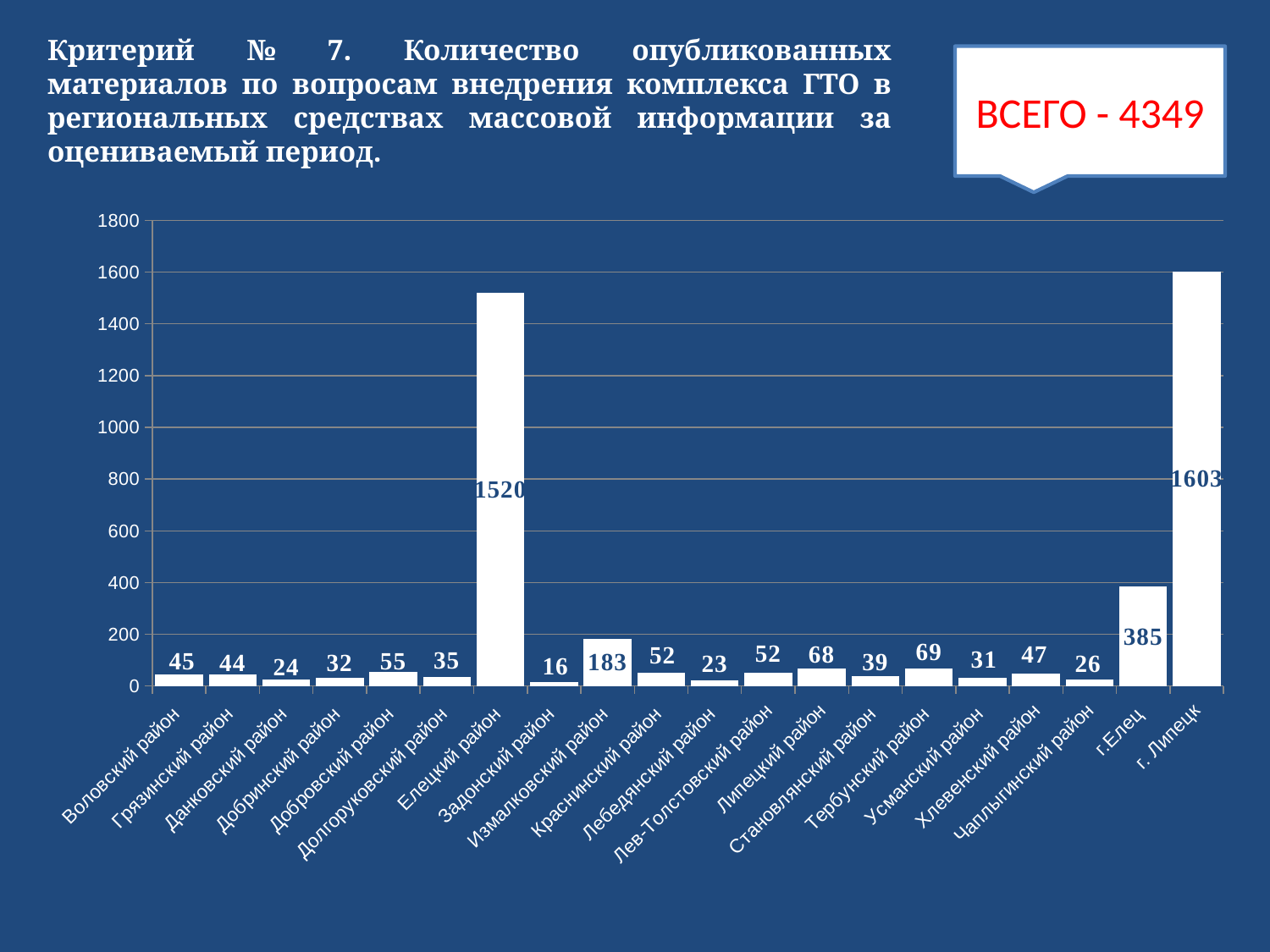
Which category has the lowest value? Задонский район Which is larger, the value for Добровский район or Долгоруковский район? Добровский район Which category has the highest value? г. Липецк What is the value for Тербунский район? 69 How many categories are shown on the x axis? 20 What is the difference between the values for г. Липецк and Елецкий район? 83 What is the value for Елецкий район? 1520 What is the difference between the values for г.Елец and Измалковский район? 202 What is the value for Измалковский район? 183 What kind of chart is shown on the slide? bar chart What is the value for г.Елец? 385 Is the value for г.Елец greater or less than 200? greater